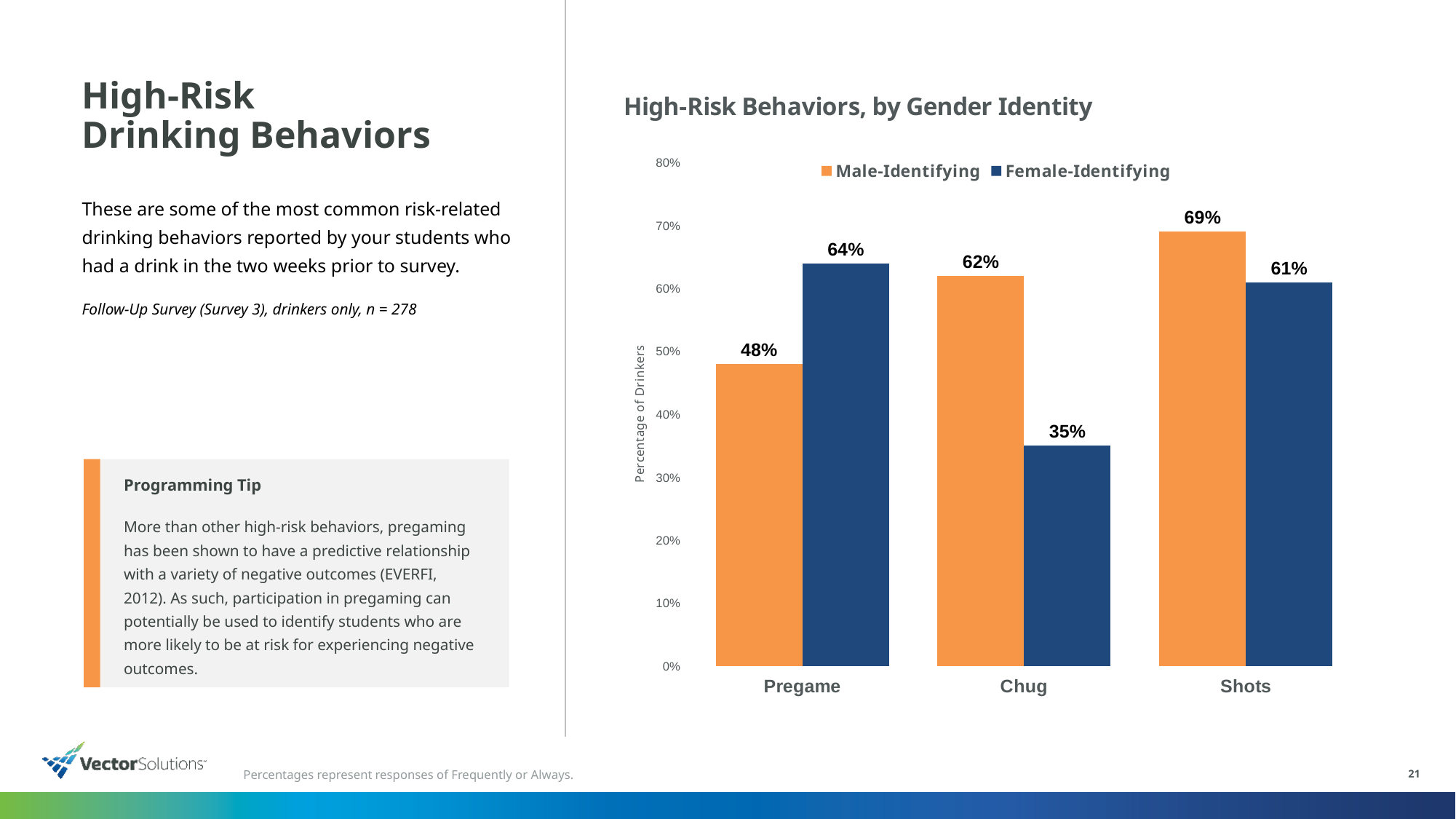
What is the title of the chart? High-Risk Behaviors, by Gender Identity What is the Female-Identifying value for Shots? 61% What is the difference between the Male-Identifying and Female-Identifying values for Chug? 27% What is the Male-Identifying value for Pregame? 48% Is the Male-Identifying value for Shots greater or less than 60%? greater How many categories are shown on the x axis? 3 Which category has the highest Male-Identifying value? Shots Which category has the lowest Female-Identifying value? Chug What is the Female-Identifying value for Chug? 35% What kind of chart is shown? Bar chart For Pregame, which is larger: the Male-Identifying or the Female-Identifying value? Female-Identifying How many series does the legend list? 2